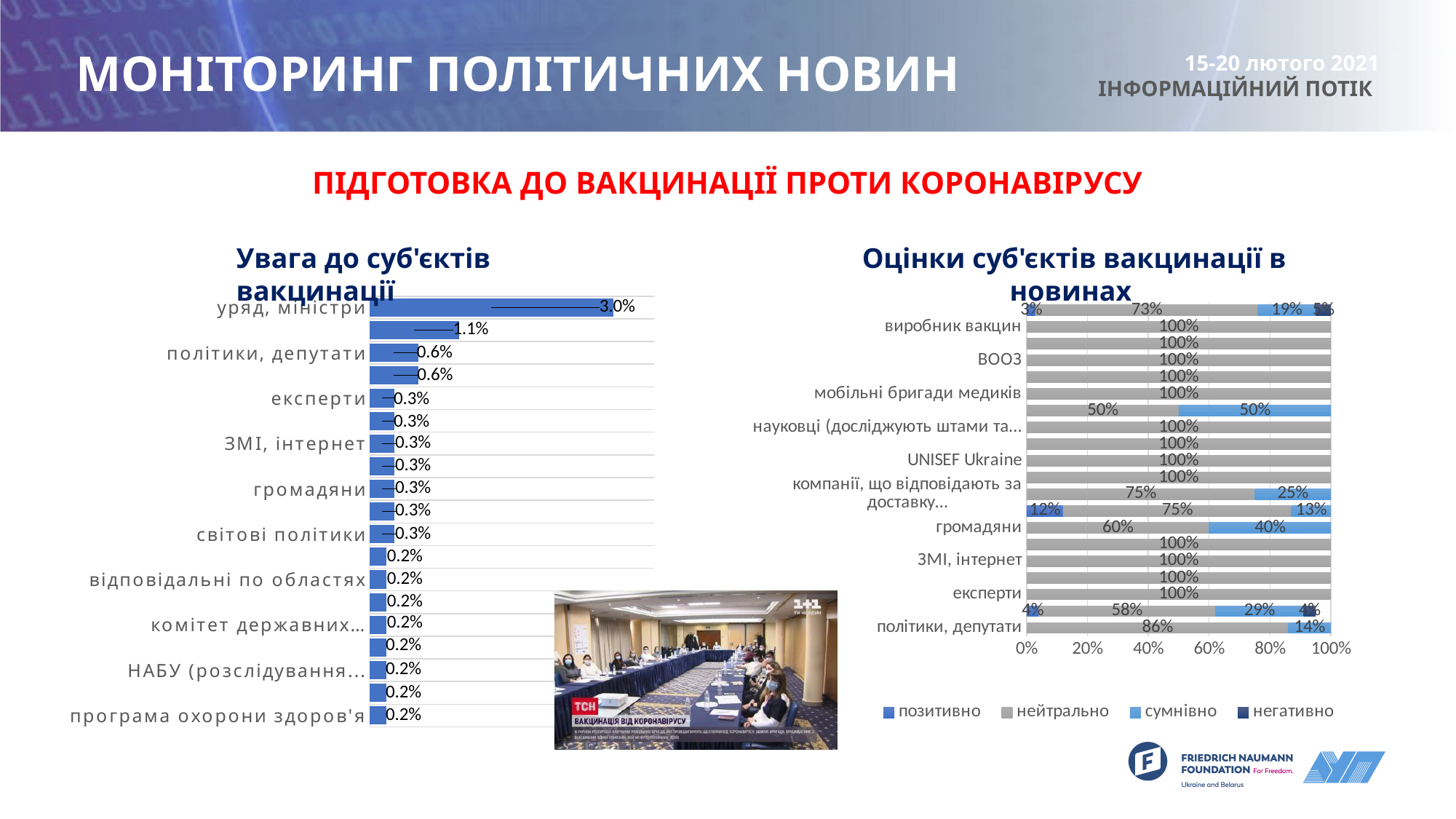
In the chart 'Увага до суб'єктів вакцинації', what is the value for 'уряд, міністри'? 3.0% In the chart 'Оцінки суб'єктів вакцинації в новинах', what is the 'сумнівно' share for 'політики, депутати'? 14% In the chart 'Увага до суб'єктів вакцинації', what is the value for 'експерти'? 0.3% How many series does the legend of the chart 'Оцінки суб'єктів вакцинації в новинах' list? 4 In the chart 'Увага до суб'єктів вакцинації', which category has the highest value? уряд, міністри In the chart 'Увага до суб'єктів вакцинації', which is larger: the value for 'громадяни' or the value for 'програма охорони здоров'я'? громадяни In the chart 'Оцінки суб'єктів вакцинації в новинах', what is the 'нейтрально' share for 'ВООЗ'? 100% In the chart 'Оцінки суб'єктів вакцинації в новинах', what is the difference between the 'нейтрально' and 'сумнівно' shares for 'компанії, що відповідають за доставку…'? 50% In the chart 'Увага до суб'єктів вакцинації', what is the difference between the values for 'уряд, міністри' and 'політики, депутати'? 2.4% In the chart 'Оцінки суб'єктів вакцинації в новинах', what is the 'нейтрально' share for 'громадяни'? 60% What kind of chart is 'Увага до суб'єктів вакцинації'? bar chart In the chart 'Увага до суб'єктів вакцинації', what is the value for 'політики, депутати'? 0.6%